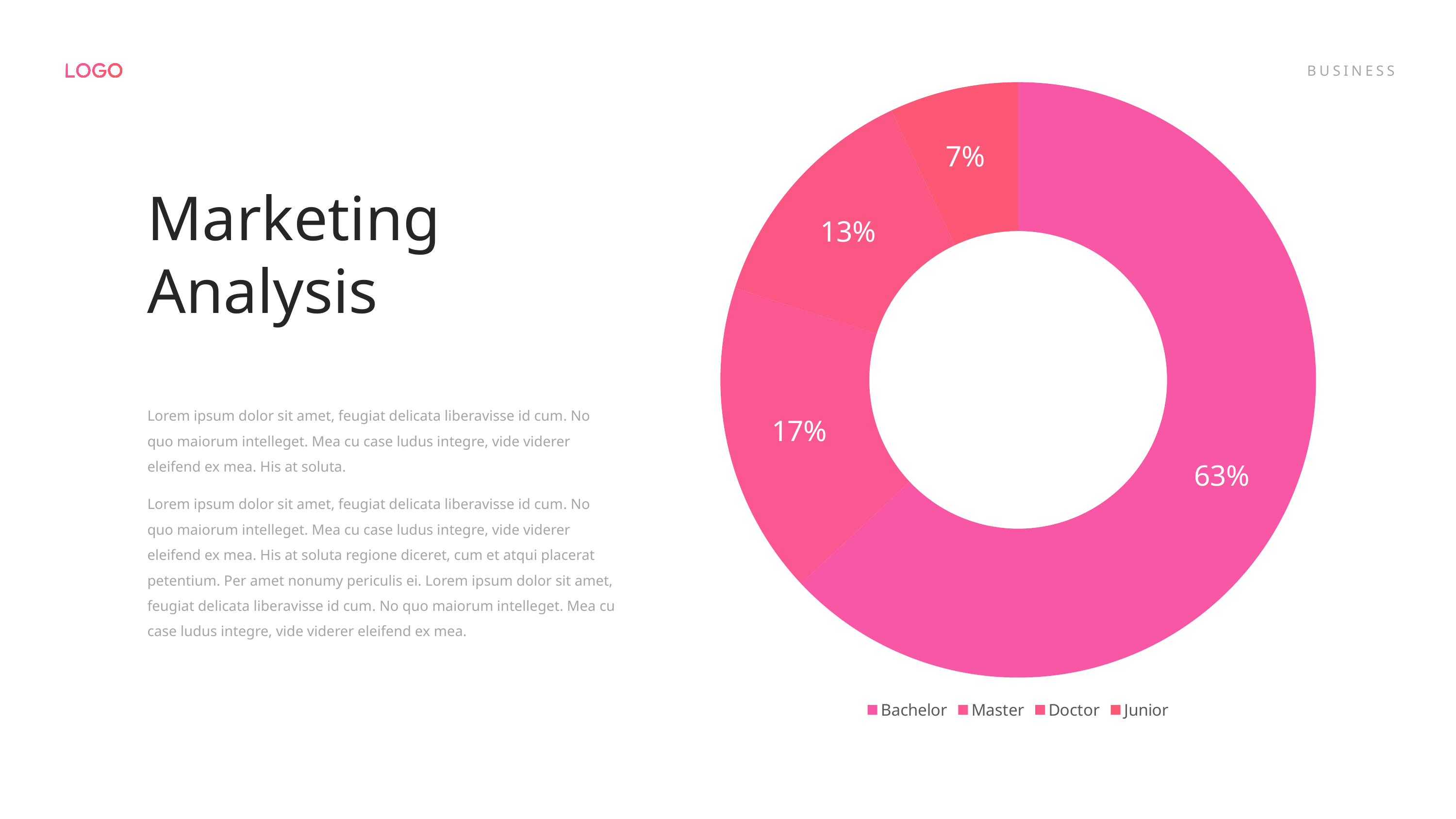
What is the title of the slide containing the chart? Marketing Analysis What kind of chart is shown on the slide? Doughnut (pie) chart What percentage is shown for Doctor? 13% Which is larger, the share for Doctor or the share for Junior? Doctor What is the combined share of Master and Doctor? 30% What percentage is shown for Master? 17% Which category has the smallest share of the chart? Junior What percentage is shown for Junior? 7% Which category has the largest share of the chart? Bachelor How many categories does the legend list? 4 What is the difference in percentage points between Bachelor and Master? 46 What percentage is shown for Bachelor? 63%